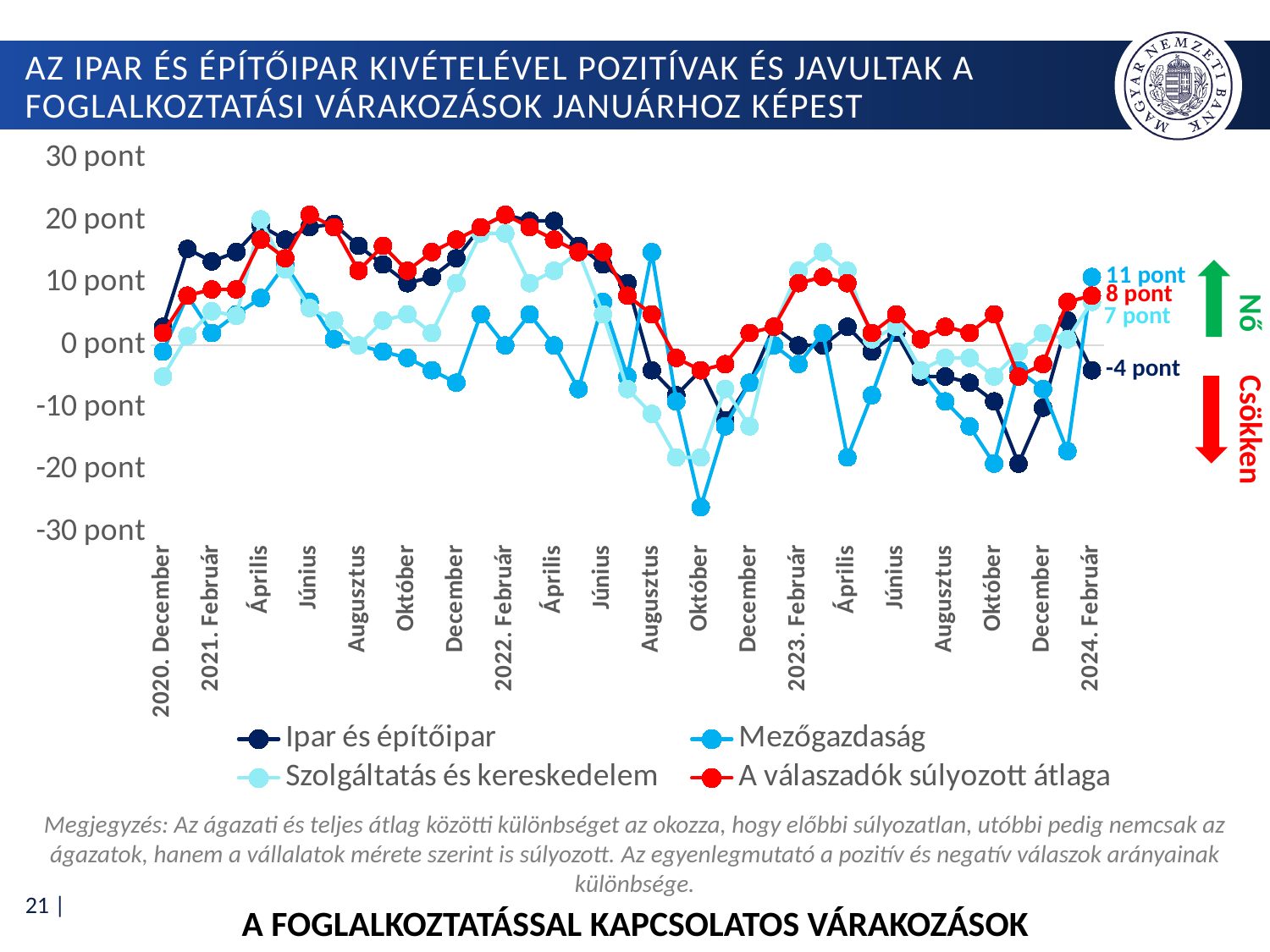
What is the value for Szolgáltatás és kereskedelem in 2024. Február? 7 pont How many series does the legend list? 4 What is the value for Ipar és építőipar in 2024. Február? -4 pont What is the value for A válaszadók súlyozott átlaga in 2024. Február? 8 pont What is the difference between the Mezőgazdaság and Ipar és építőipar values in 2024. Február? 15 pont In 2024. Február, which is larger: A válaszadók súlyozott átlaga or Szolgáltatás és kereskedelem? A válaszadók súlyozott átlaga Which series has the lowest value in 2024. Február? Ipar és építőipar Is the value for Ipar és építőipar in 2021. Június greater or less than 10 pont? greater Is the value for Mezőgazdaság in 2022. Október greater or less than -20 pont? less Which series has the highest value in 2024. Február? Mezőgazdaság What is the value for Mezőgazdaság in 2024. Február? 11 pont What kind of chart is shown on the slide? Line chart